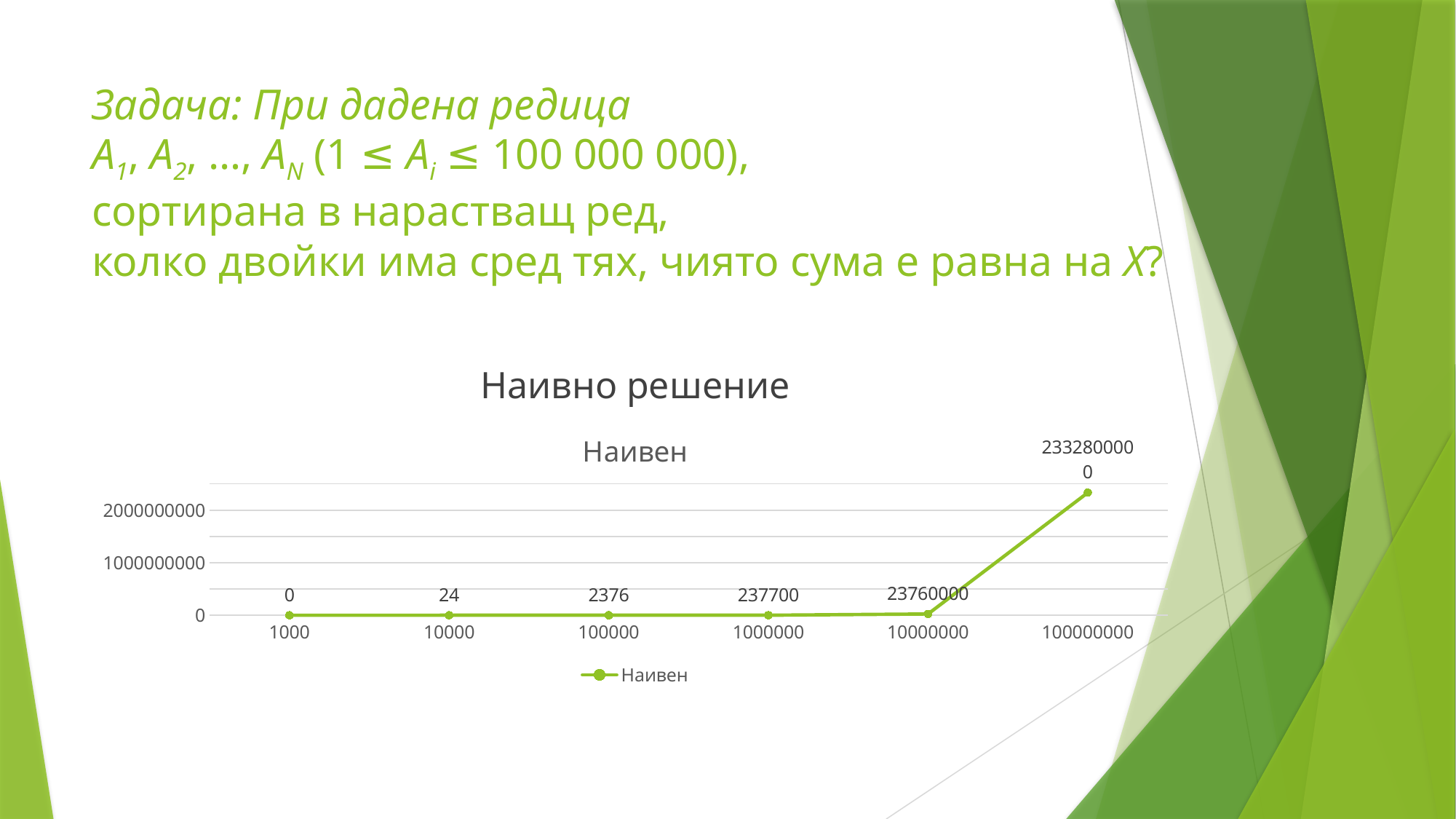
Is the value for 100000000 greater or less than 2000000000? greater What is the value for 1000000 in the Наивен chart? 237700 Which x-axis category has the highest value? 100000000 Do the values rise or fall as you move along the x axis? rise What kind of chart is shown on the slide? line chart What is the difference between the values for 1000000 and 100000? 235324 What is the value for 10000000 in the Наивен chart? 23760000 What is the value for 100000 in the Наивен chart? 2376 What is the value for 1000 in the Наивен chart? 0 How many data points are plotted on the chart? 6 What is the value for 10000 in the Наивен chart? 24 Which x-axis category has the lowest value? 1000